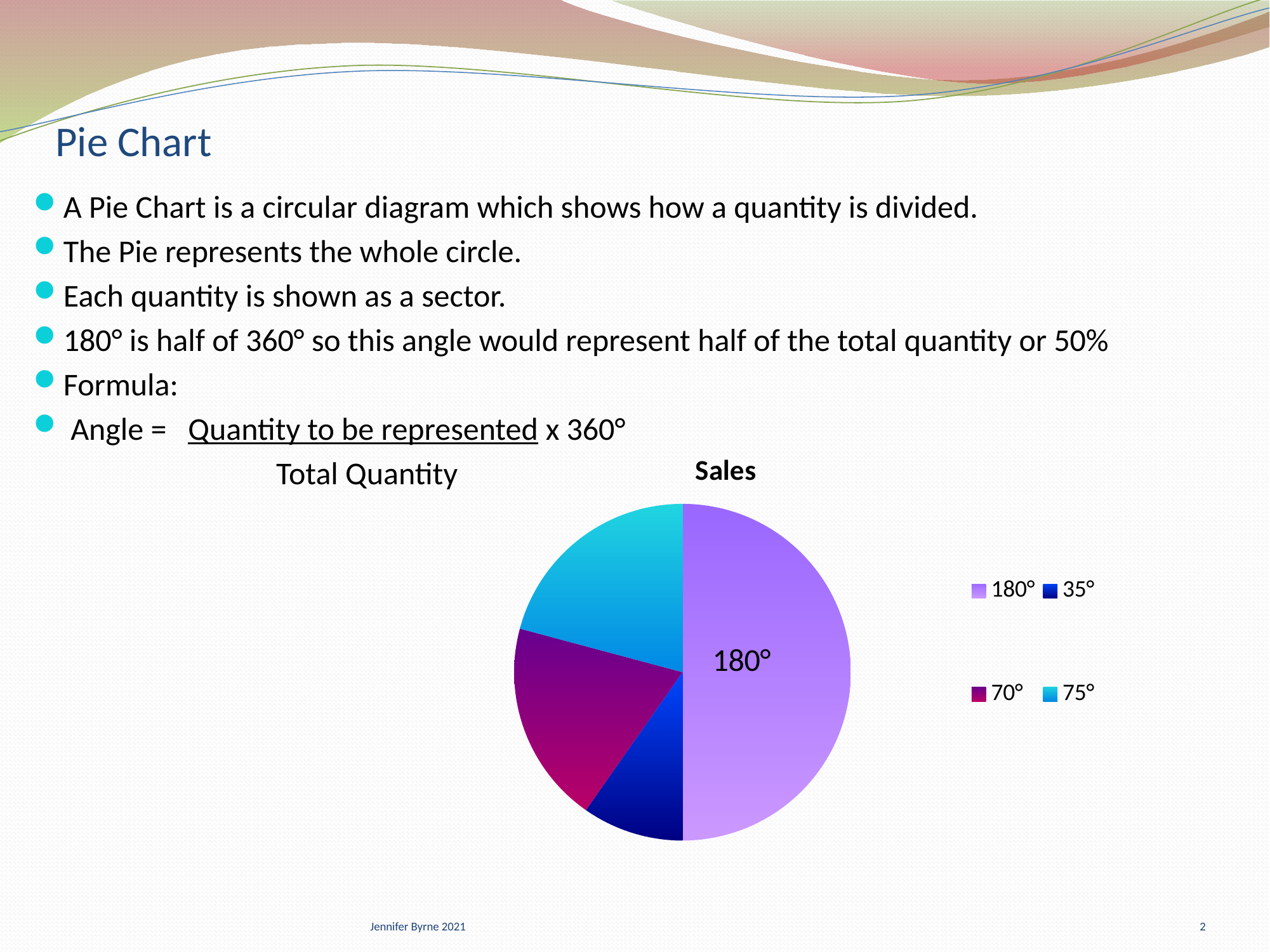
Which slice of the Sales pie chart is the smallest? 35° In the Sales pie chart, which slice is larger, the 180° slice or the 35° slice? 180° What share of the Sales pie does the 180° slice represent? 50% In the Sales pie chart, which slice is larger, the 75° slice or the 35° slice? 75° How many slices does the Sales pie chart have? 4 Which slice of the Sales pie chart is the largest? 180° What kind of chart is shown on the slide? pie chart How many entries does the legend of the Sales pie chart list? 4 What data label is printed on the largest slice of the Sales pie chart? 180° Which legend entry in the Sales pie chart is shown in dark blue? 35° What is the title of the pie chart? Sales